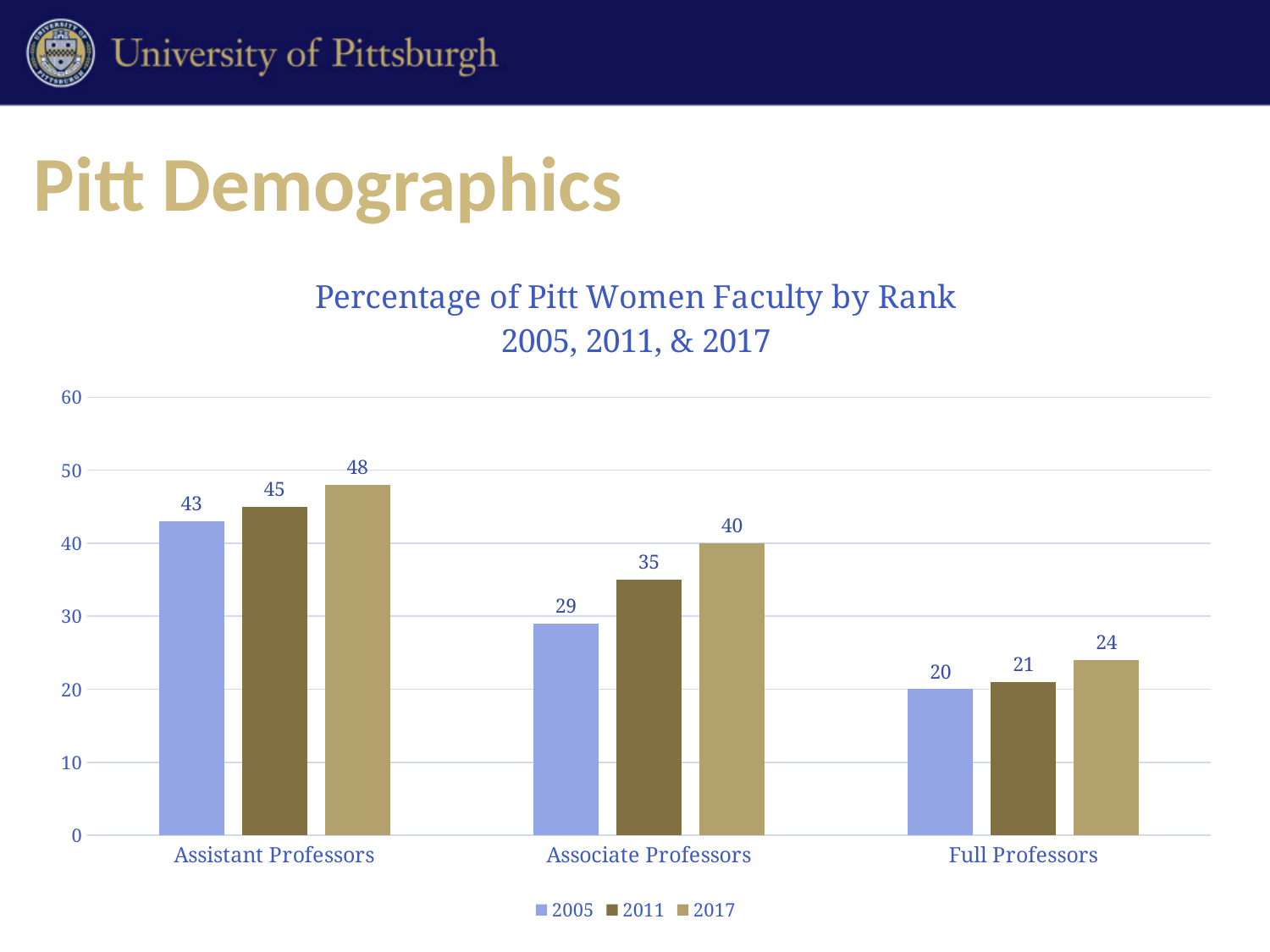
What is the title of the chart? Percentage of Pitt Women Faculty by Rank 2005, 2011, & 2017 What is the value for Associate Professors in 2011? 35 Do the values for Full Professors rise or fall from 2005 to 2017? Rise What is the value for Assistant Professors in 2017? 48 Which rank has the highest value in 2017? Assistant Professors What kind of chart is shown? Bar chart Which rank has the lowest value in 2005? Full Professors What is the value for Full Professors in 2005? 20 How many series does the legend list? 3 How many ranks (categories) are shown on the x axis? 3 What is the difference between the 2017 and 2005 values for Associate Professors? 11 Which is larger: the 2011 value for Associate Professors or the 2017 value for Full Professors? 2011 value for Associate Professors